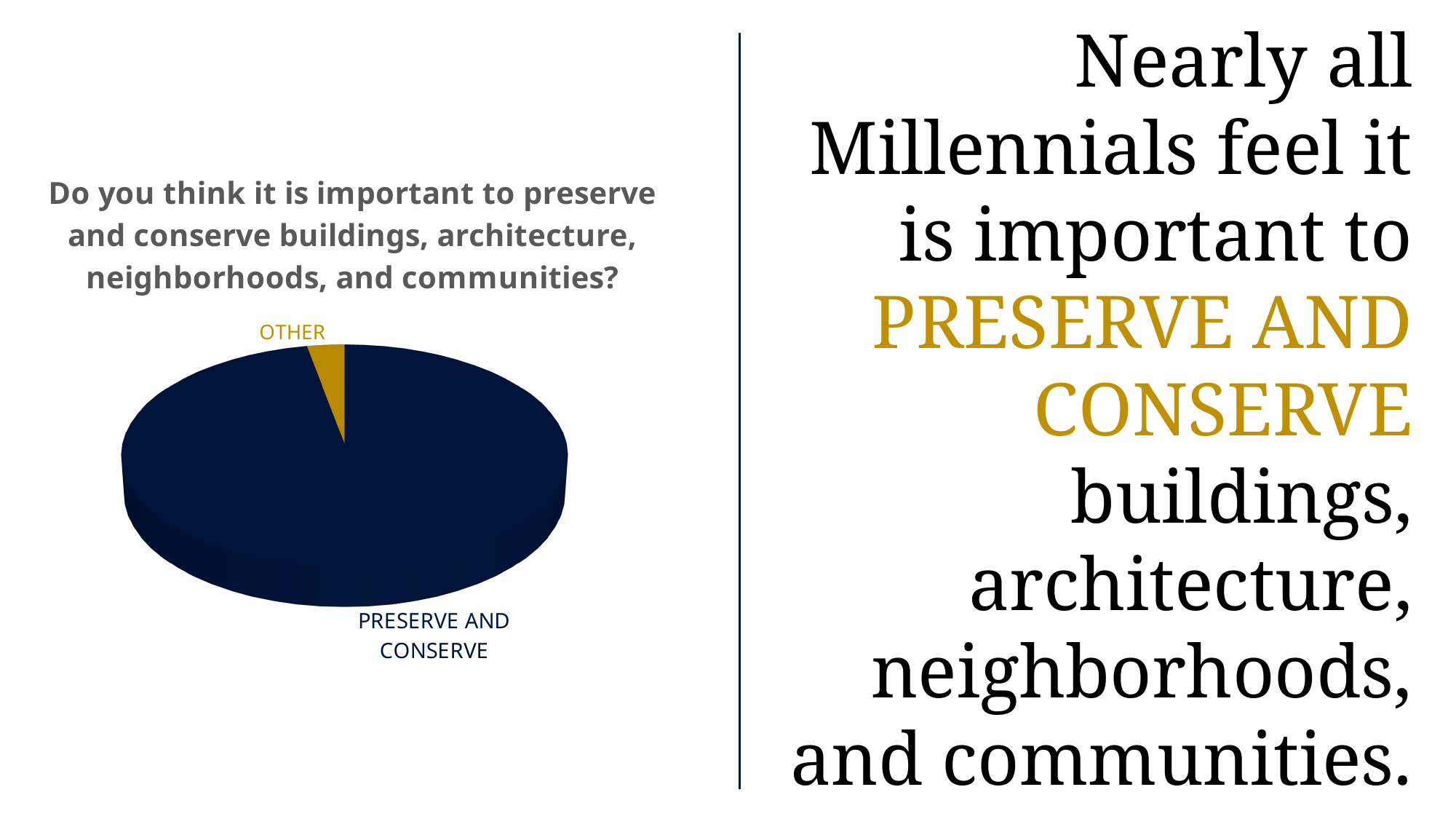
What is the title of the pie chart? Do you think it is important to preserve and conserve buildings, architecture, neighborhoods, and communities? What kind of chart is shown on the slide? pie chart Which slice is larger, PRESERVE AND CONSERVE or OTHER? PRESERVE AND CONSERVE How many slices does the pie chart have? 2 What colour is the OTHER slice of the pie chart? gold Which slice of the pie chart is the smallest? OTHER Which slice of the pie chart is the largest? PRESERVE AND CONSERVE